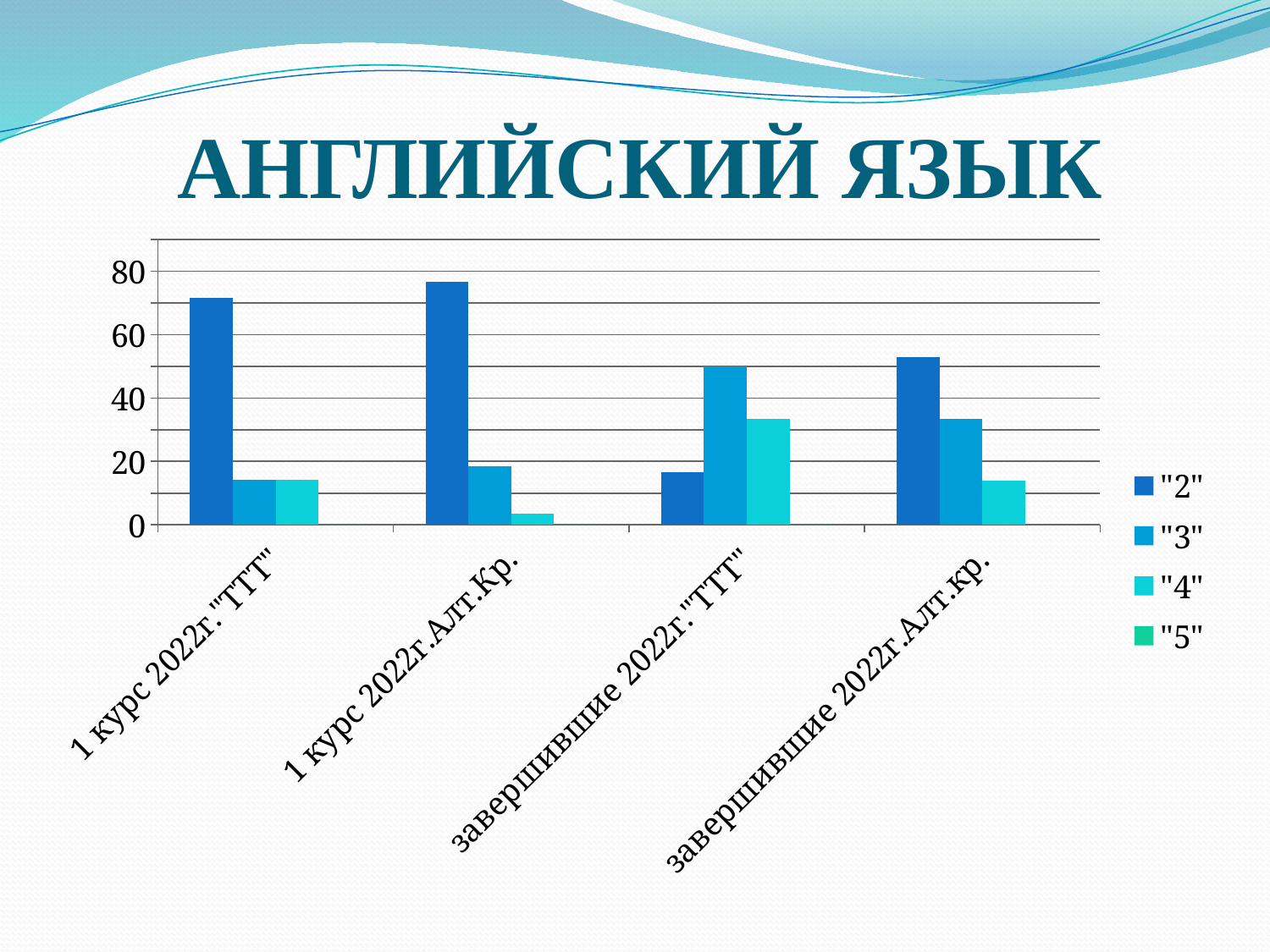
Which category has the lowest value for series "2"? завершившие 2022г."ТТТ" Which category has the highest value for series "2"? 1 курс 2022г.Алт.Кр. For завершившие 2022г."ТТТ", which series has the larger value, "2" or "3"? "3" Is the value of series "2" for завершившие 2022г.Алт.кр. greater or less than 40? greater Is the value of series "2" for завершившие 2022г."ТТТ" greater or less than 20? less What kind of chart is shown on the slide? bar chart Is the value of series "4" for 1 курс 2022г.Алт.Кр. greater or less than 20? less How many categories are shown on the x axis? 4 What is the title of the slide with the chart? АНГЛИЙСКИЙ ЯЗЫК How many series does the legend list? 4